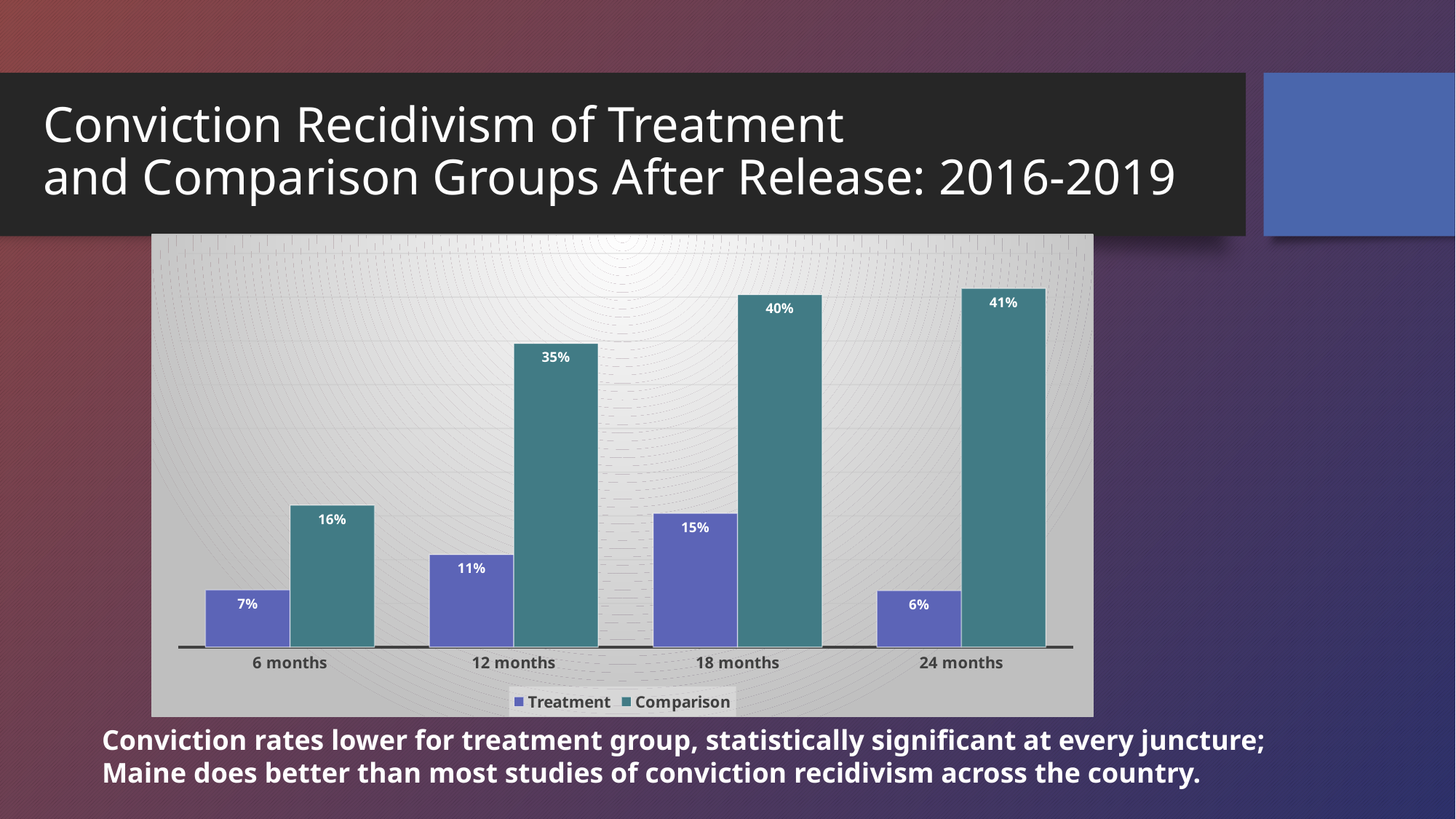
What is the Treatment group's value at 24 months? 6% At which time point is the Comparison group's rate highest? 24 months How many time points are shown on the x axis? 4 What is the Treatment group's conviction recidivism rate at 18 months? 15% At which time point is the Treatment group's rate lowest? 24 months Which group has the higher rate at 6 months, Treatment or Comparison? Comparison What is the Comparison group's conviction recidivism rate at 12 months? 35% How many series does the legend list? 2 What is the difference between the Comparison and Treatment rates at 18 months? 25% What kind of chart is shown on the slide? Bar chart Does the Comparison group's rate rise or fall from 6 months to 24 months? Rise What are the two series named in the legend? Treatment and Comparison